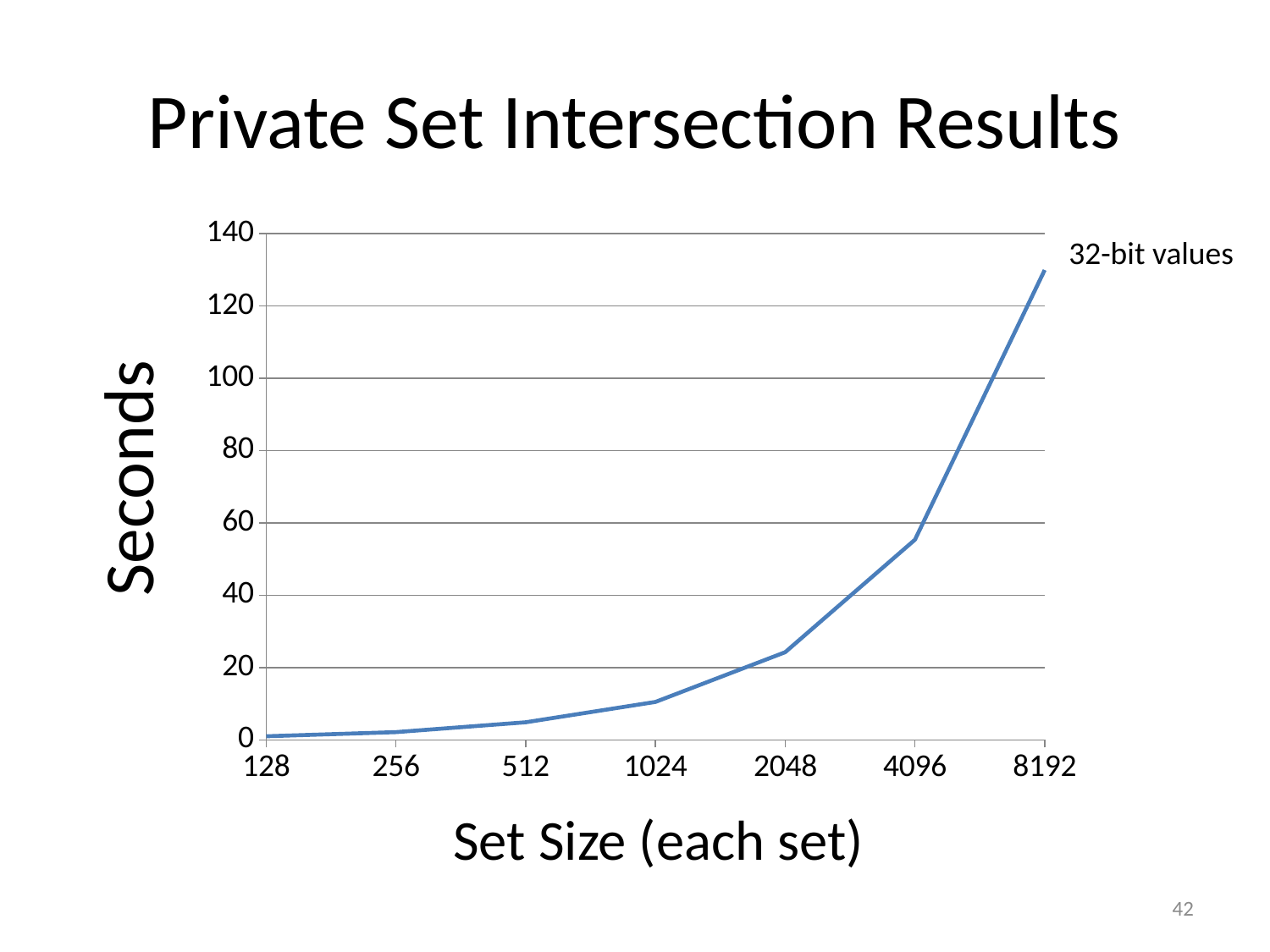
Do the values rise or fall as the set size increases along the x axis? rise What is the title of the chart? Private Set Intersection Results Which set size takes more seconds, 4096 or 8192? 8192 Which set size has the lowest time in seconds? 128 Is the value for set size 8192 greater or less than 120 seconds? greater How many set sizes are plotted along the x axis? 7 What kind of chart is shown on the slide? line chart Which set size has the highest time in seconds? 8192 Is the value for set size 4096 greater or less than 40 seconds? greater Is the value for set size 2048 greater or less than 40 seconds? less How many series does the legend list? 1 What label does the legend show for the plotted series? 32-bit values